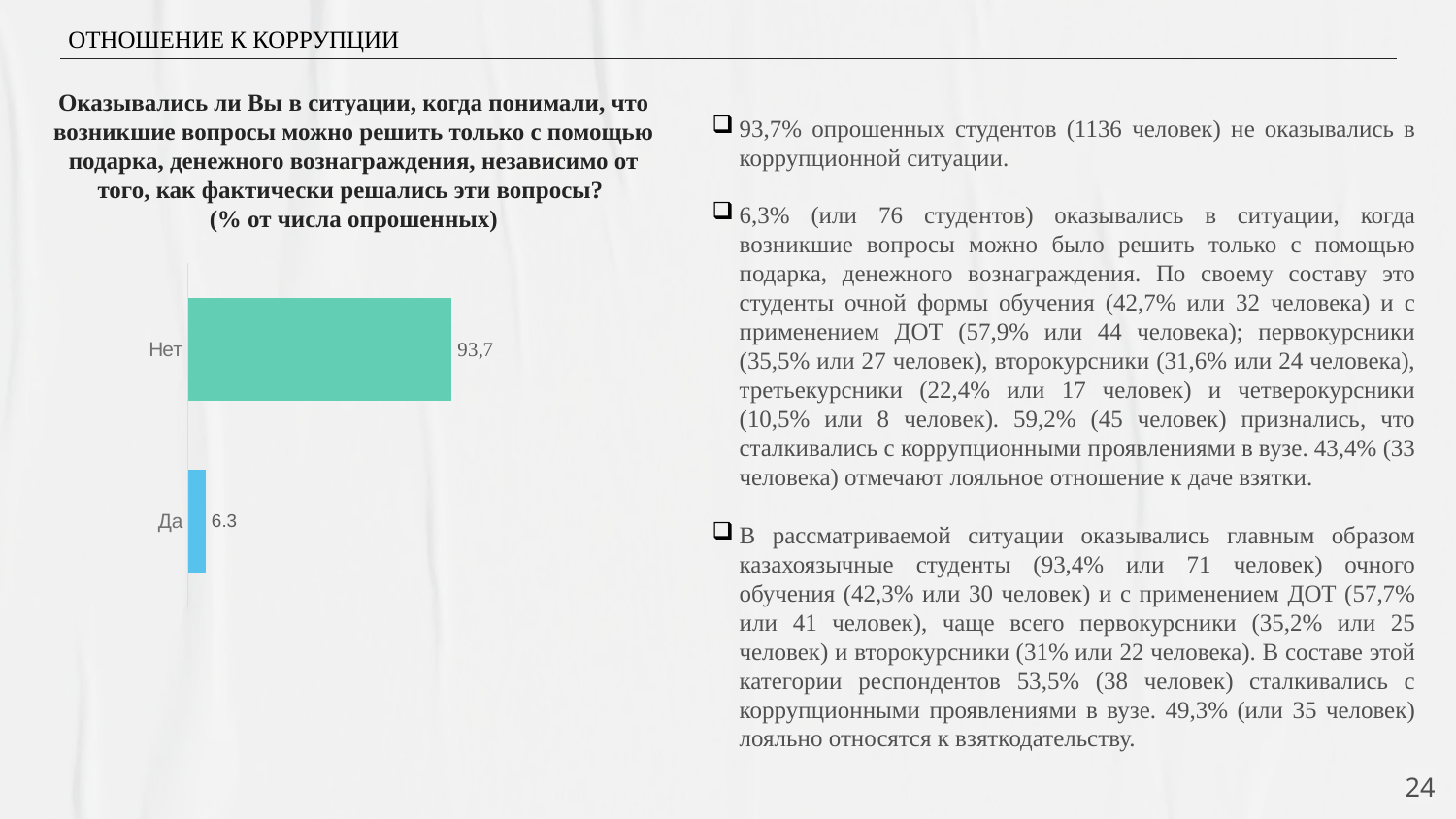
Which is larger in the chart, the value for "Да" or the value for "Нет"? Нет What unit does the chart title say the values are expressed in? % от числа опрошенных What is the value for "Да" in the chart? 6.3 What is the difference between the values for "Нет" and "Да" in the chart? 87,4 How many categories are shown in the chart? 2 Which category has the highest value in the chart? Нет Which category has the lowest value in the chart? Да What colour is the bar for "Да" in the chart? Blue What is the value for "Нет" in the chart? 93,7 What type of chart is shown on the slide? Bar chart